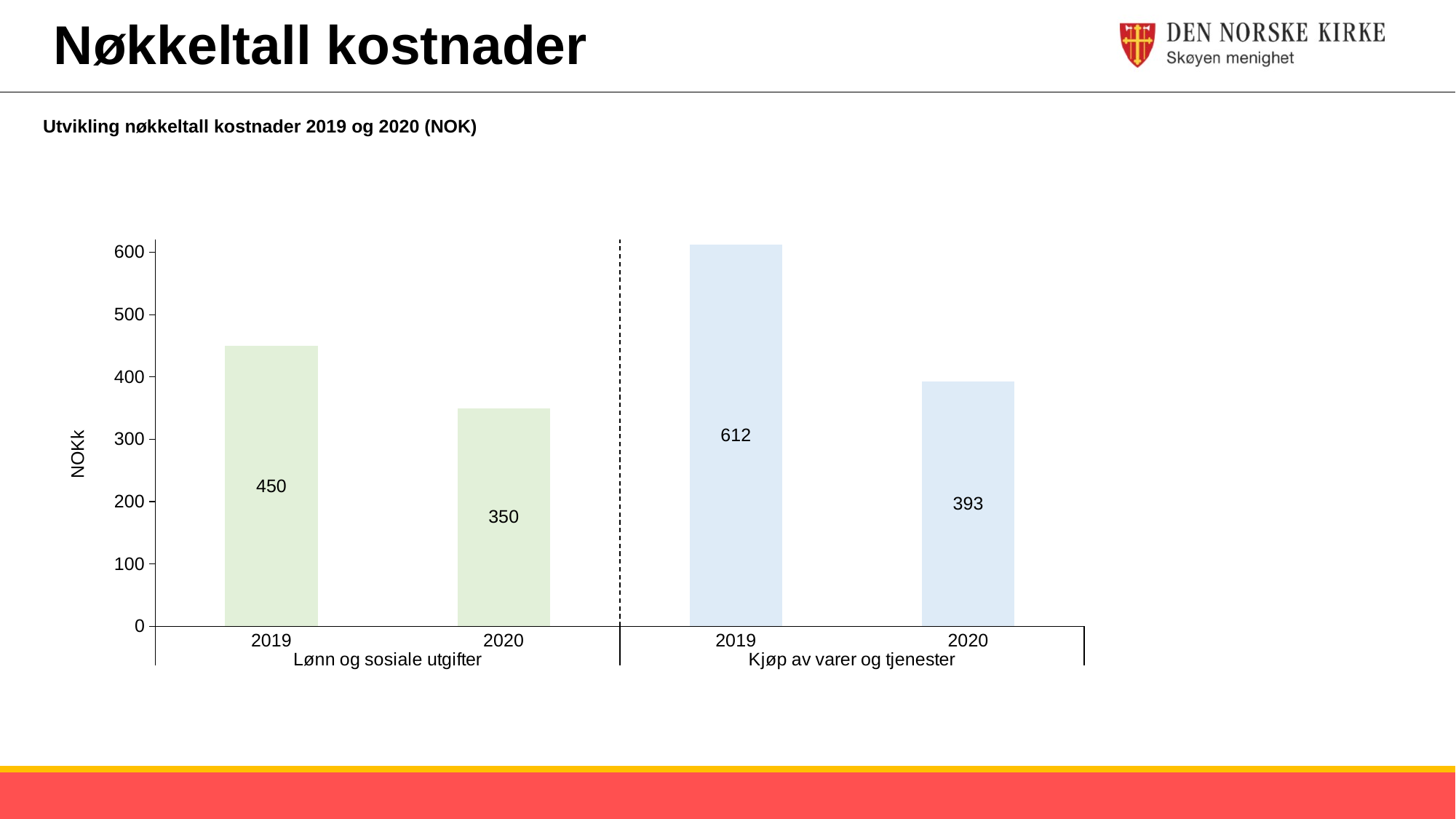
Which bar has the lowest value on the chart? Lønn og sosiale utgifter 2020 How many bars are plotted on the chart? 4 What is the difference between the 2019 and 2020 values for Lønn og sosiale utgifter? 100 Which is larger: Lønn og sosiale utgifter in 2019 or Kjøp av varer og tjenester in 2020? Lønn og sosiale utgifter in 2019 What is the value for Lønn og sosiale utgifter in 2020? 350 What is the difference between the 2019 and 2020 values for Kjøp av varer og tjenester? 219 What is the label on the vertical axis of the chart? NOKk What is the value for Kjøp av varer og tjenester in 2020? 393 What kind of chart is shown on the slide? Bar chart What is the value for Kjøp av varer og tjenester in 2019? 612 Which bar has the highest value on the chart? Kjøp av varer og tjenester 2019 What is the value for Lønn og sosiale utgifter in 2019? 450